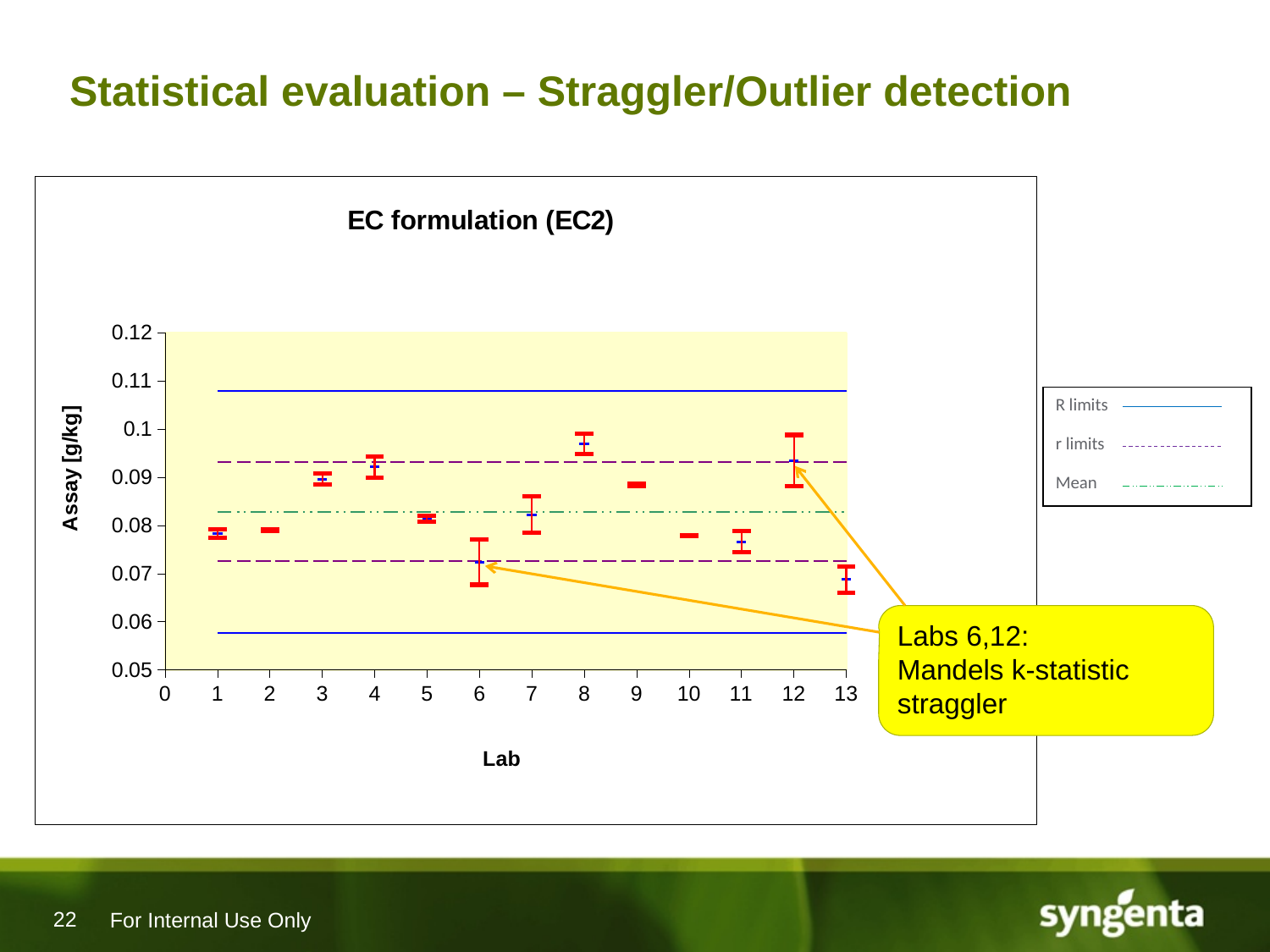
How many labs are plotted on the chart? 13 Which lab has the highest mean assay value? Lab 8 Is the mean value for Lab 13 greater or less than 0.08? less What is the title of the chart? EC formulation (EC2) Which has the larger mean assay value, Lab 6 or Lab 8? Lab 8 Which lab has the lowest mean assay value? Lab 13 Is the mean value for Lab 8 greater or less than 0.09? greater What is the label of the y axis? Assay [g/kg] What kind of chart is shown on the slide? Scatter plot with error bars Which has the larger mean assay value, Lab 3 or Lab 2? Lab 3 How many entries does the chart legend list? 3 Is the mean value for Lab 6 greater or less than 0.08? less